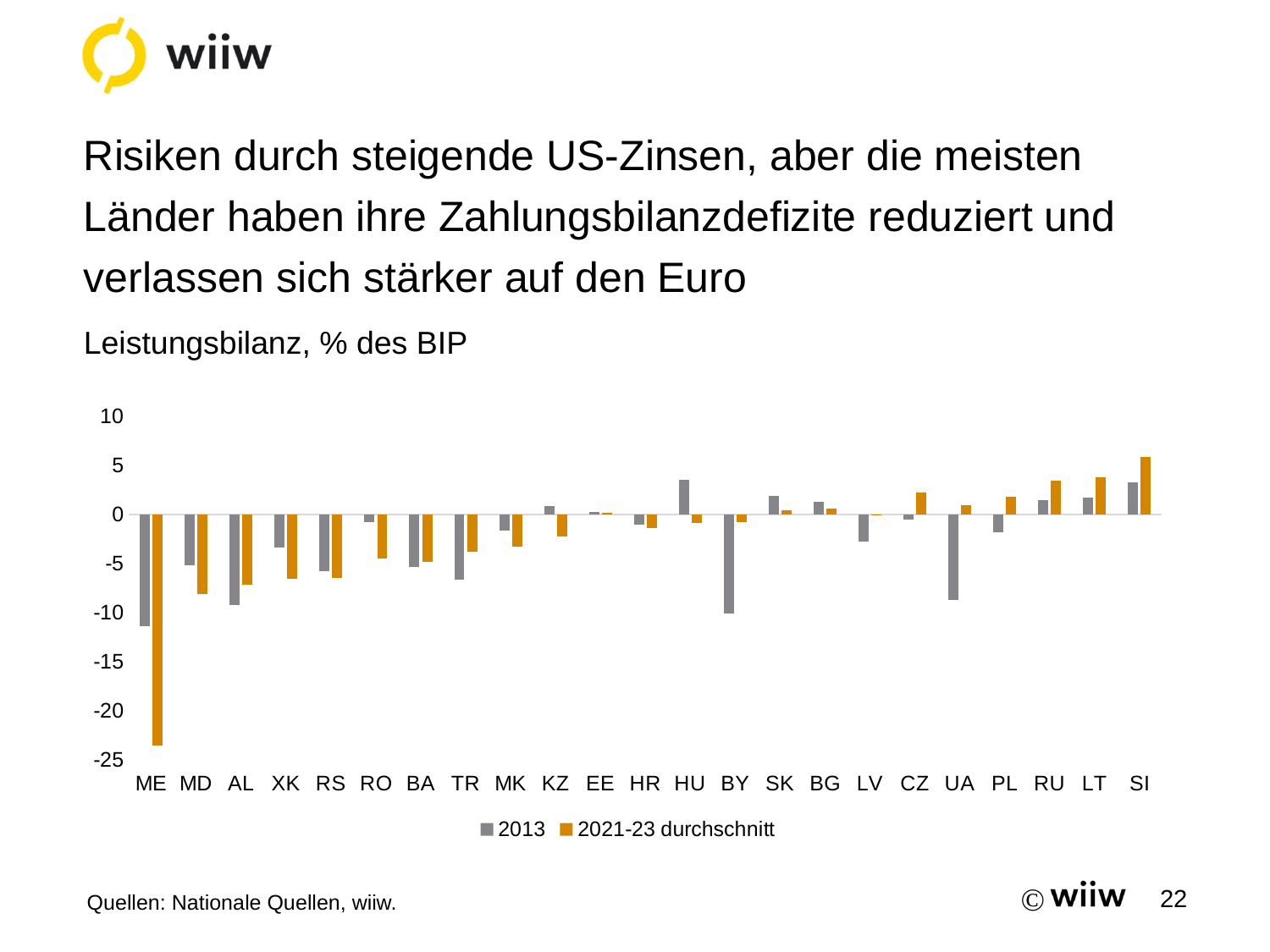
Is the 2013 value for UA greater or less than -5? less For UA, which series has the larger value, 2013 or 2021-23 durchschnitt? 2021-23 durchschnitt Which is larger, the 2021-23 durchschnitt value for SI or for RU? SI How many countries are shown on the x axis? 23 Is the 2021-23 durchschnitt value for SI greater or less than 5? greater Which country has the highest value for the 2021-23 durchschnitt series? SI Is the 2021-23 durchschnitt value for MD greater or less than -5? less What unit is the chart measured in, according to the subtitle? % des BIP Which country has the lowest value for the 2021-23 durchschnitt series? ME What kind of chart is shown on the slide? bar chart How many series does the legend list? 2